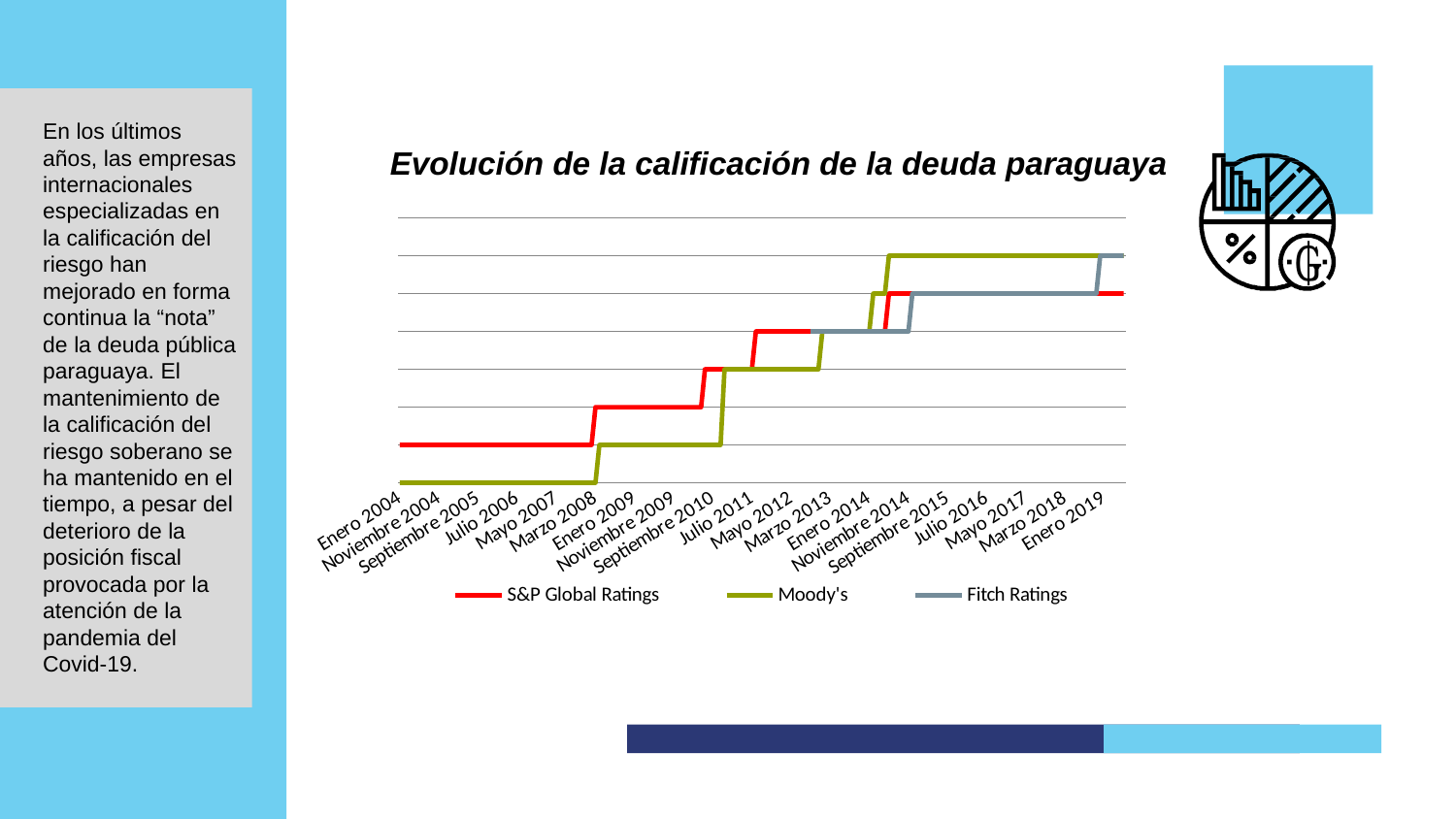
At the end of the chart, is the Moody's line higher or lower than the S&P Global Ratings line? Higher How many labels are shown on the x axis? 19 What is the last label on the x axis? Enero 2019 Which series begins latest on the x axis? Fitch Ratings Which series is drawn in red? S&P Global Ratings Do the rating lines generally rise or fall from left to right along the x axis? Rise What kind of chart is shown on the slide? Line chart How many series does the legend list? 3 Which series is at the lowest level at the start of the chart (Enero 2004)? Moody's What is the title of the chart? Evolución de la calificación de la deuda paraguaya What is the first label on the x axis? Enero 2004 Which series is at the lowest level at the end of the chart (Enero 2019)? S&P Global Ratings